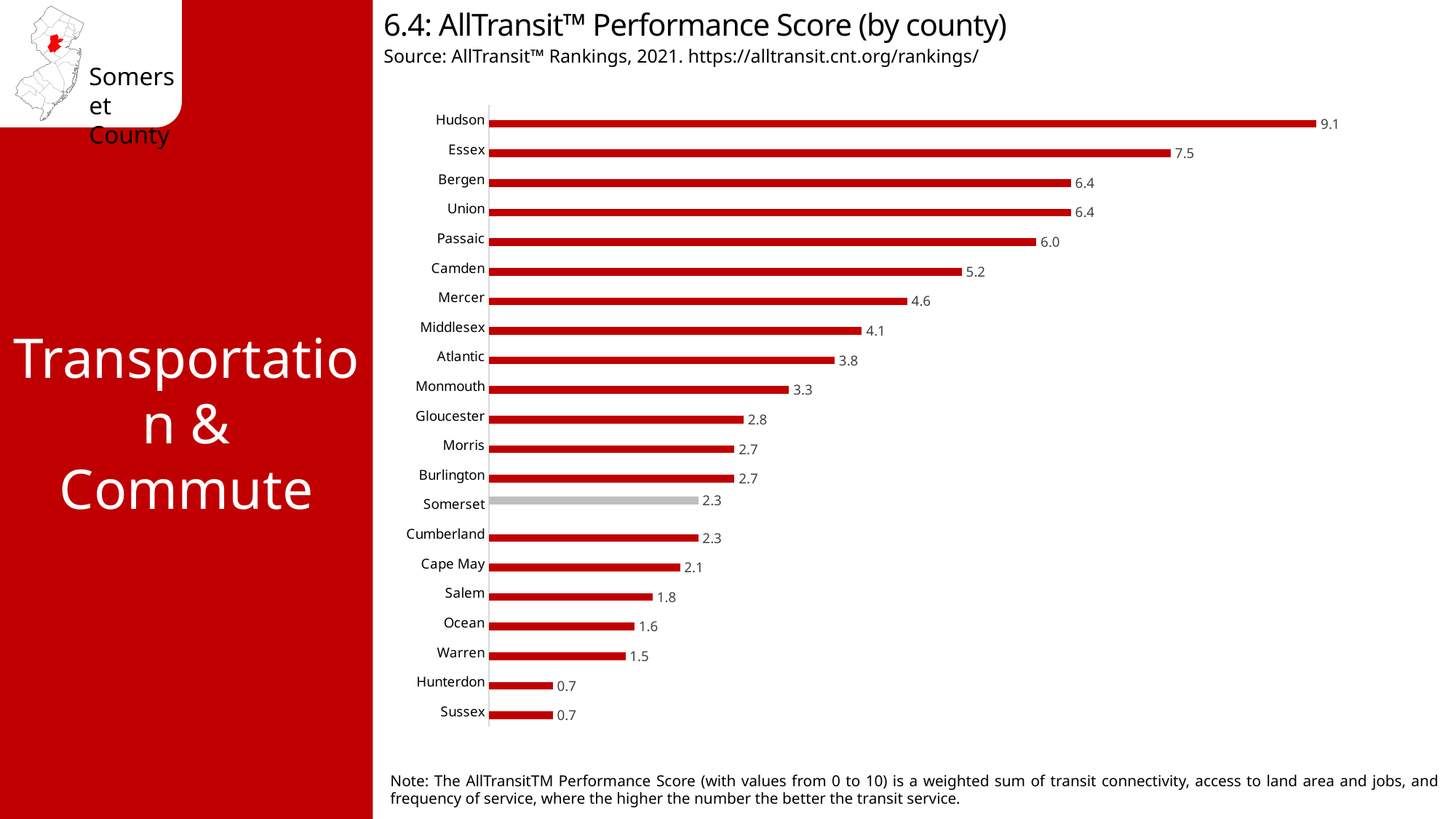
Which county has a higher score, Monmouth or Atlantic? Atlantic Which county's bar is shown in grey instead of red? Somerset What is the difference between the scores of Hudson and Essex counties? 1.6 How much higher is Hudson's score than Somerset's score? 6.8 What is the AllTransit Performance Score for Hudson County? 9.1 What is the AllTransit Performance Score for Mercer County? 4.6 How many counties are shown in the chart? 21 What is the AllTransit Performance Score for Passaic County? 6.0 What kind of chart is used to show the AllTransit Performance Scores? Bar chart Which county has the highest AllTransit Performance Score? Hudson Which county has a higher score, Camden or Mercer? Camden What is the AllTransit Performance Score for Somerset County? 2.3